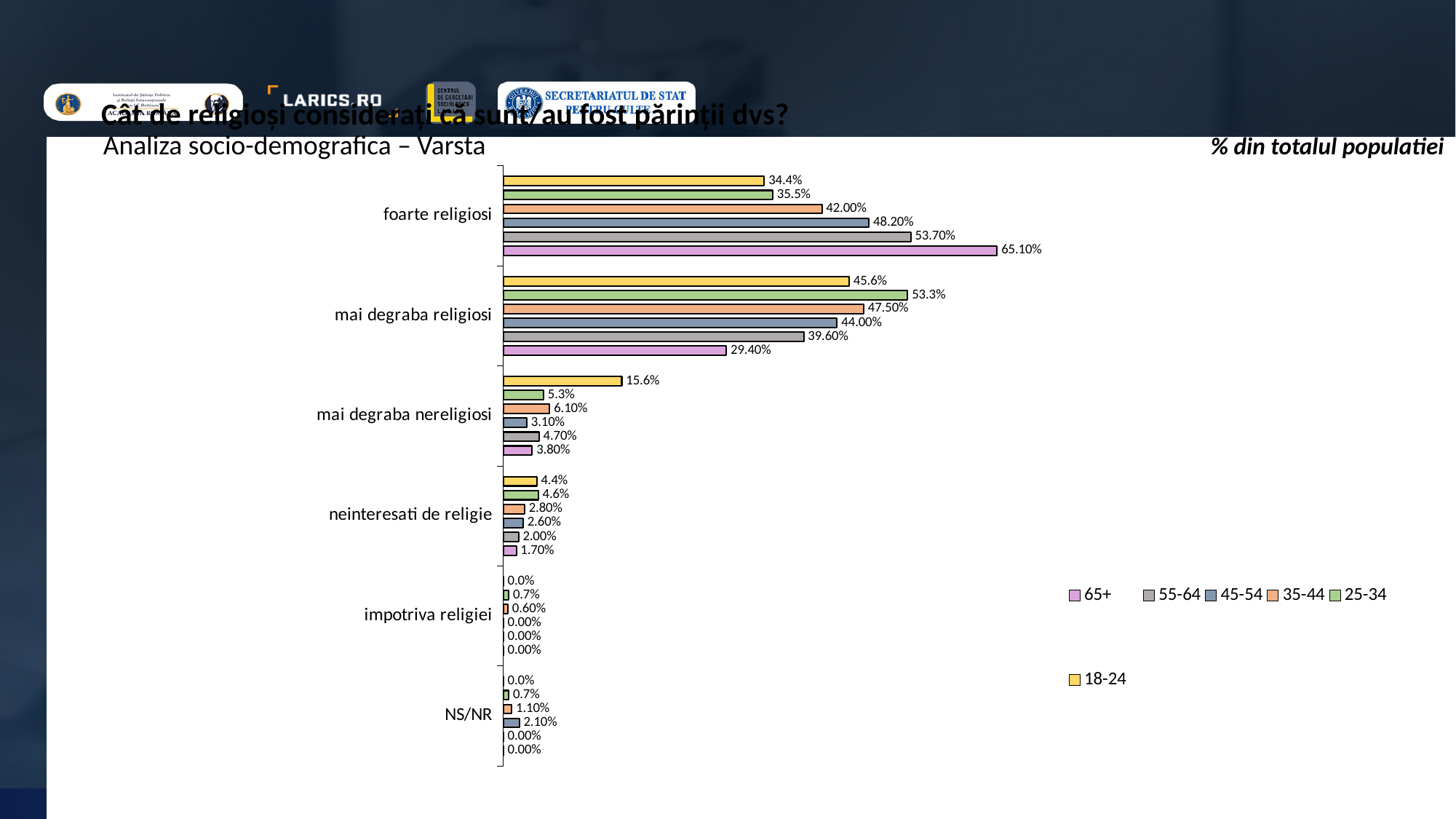
What is the subtitle shown above the chart on the left? Analiza socio-demografica – Varsta How many categories are shown on the vertical axis? 6 What is the difference between the 65+ and 18-24 values in the 'foarte religiosi' category? 30.7% What is the value for the 18-24 series in the 'mai degraba nereligiosi' category? 15.6% What is the value for the 65+ series in the 'foarte religiosi' category? 65.10% What is the value for the 25-34 series in the 'mai degraba religiosi' category? 53.3% Which age series has the lowest value in the 'mai degraba religiosi' category? 65+ What type of chart is shown on the slide? bar chart How many series does the legend list? 6 Which age series has the highest value in the 'foarte religiosi' category? 65+ What is the value for the 45-54 series in the 'NS/NR' category? 2.10% In the 'neinteresati de religie' category, which is larger: the 35-44 value or the 55-64 value? 35-44